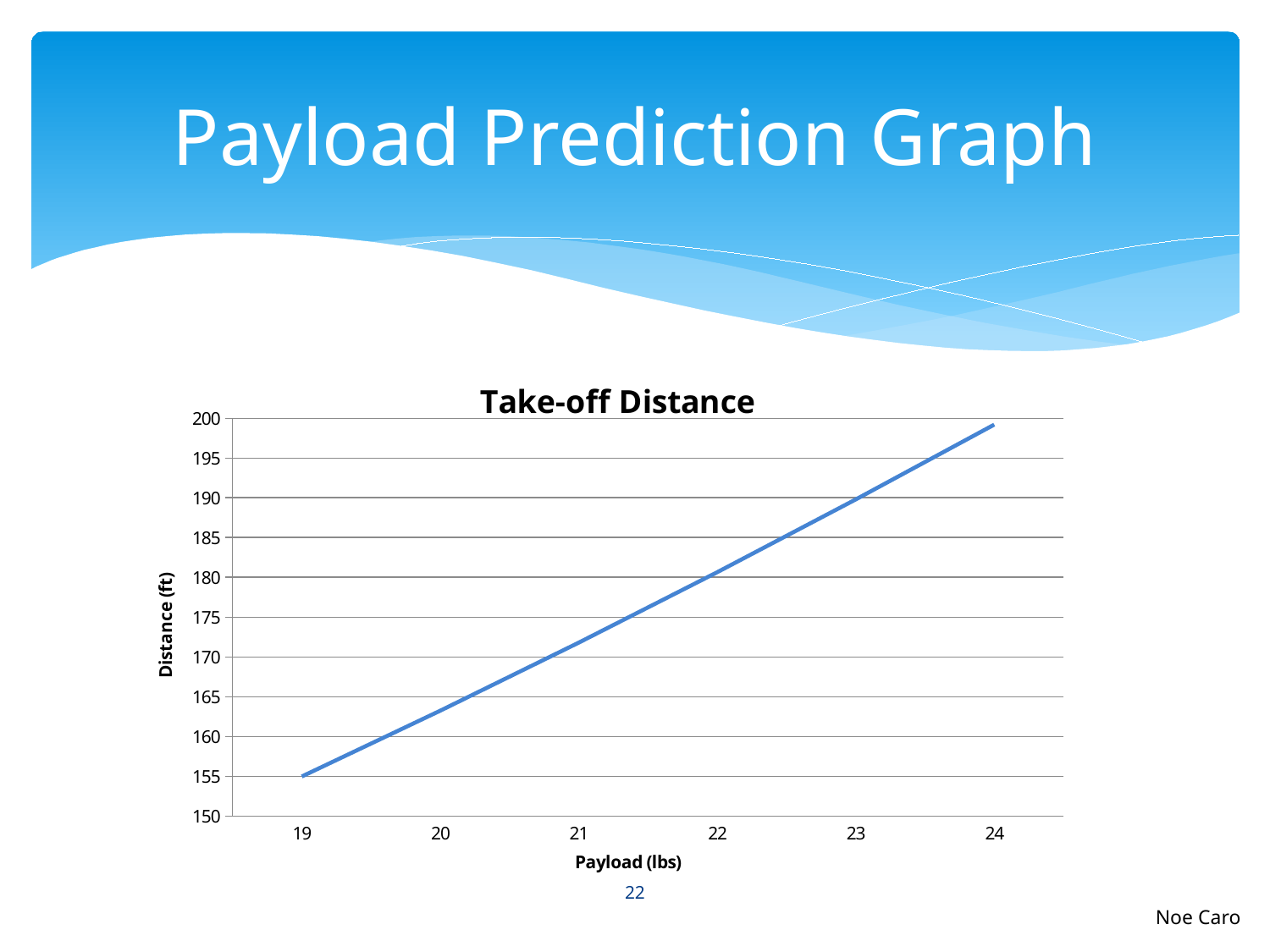
How many payload values are marked on the x axis? 6 What kind of chart is shown on the slide? line chart What is the take-off distance at a payload of 19 lbs? 155 Which payload has the higher take-off distance, 20 lbs or 23 lbs? 23 lbs Is the take-off distance at a payload of 23 lbs greater or less than 185? greater Is the take-off distance at a payload of 21 lbs greater or less than 170? greater Is the take-off distance at a payload of 24 lbs greater or less than 195? greater What is the title of the chart? Take-off Distance Does the take-off distance rise or fall as payload increases along the x axis? rise What is the label of the x axis? Payload (lbs)